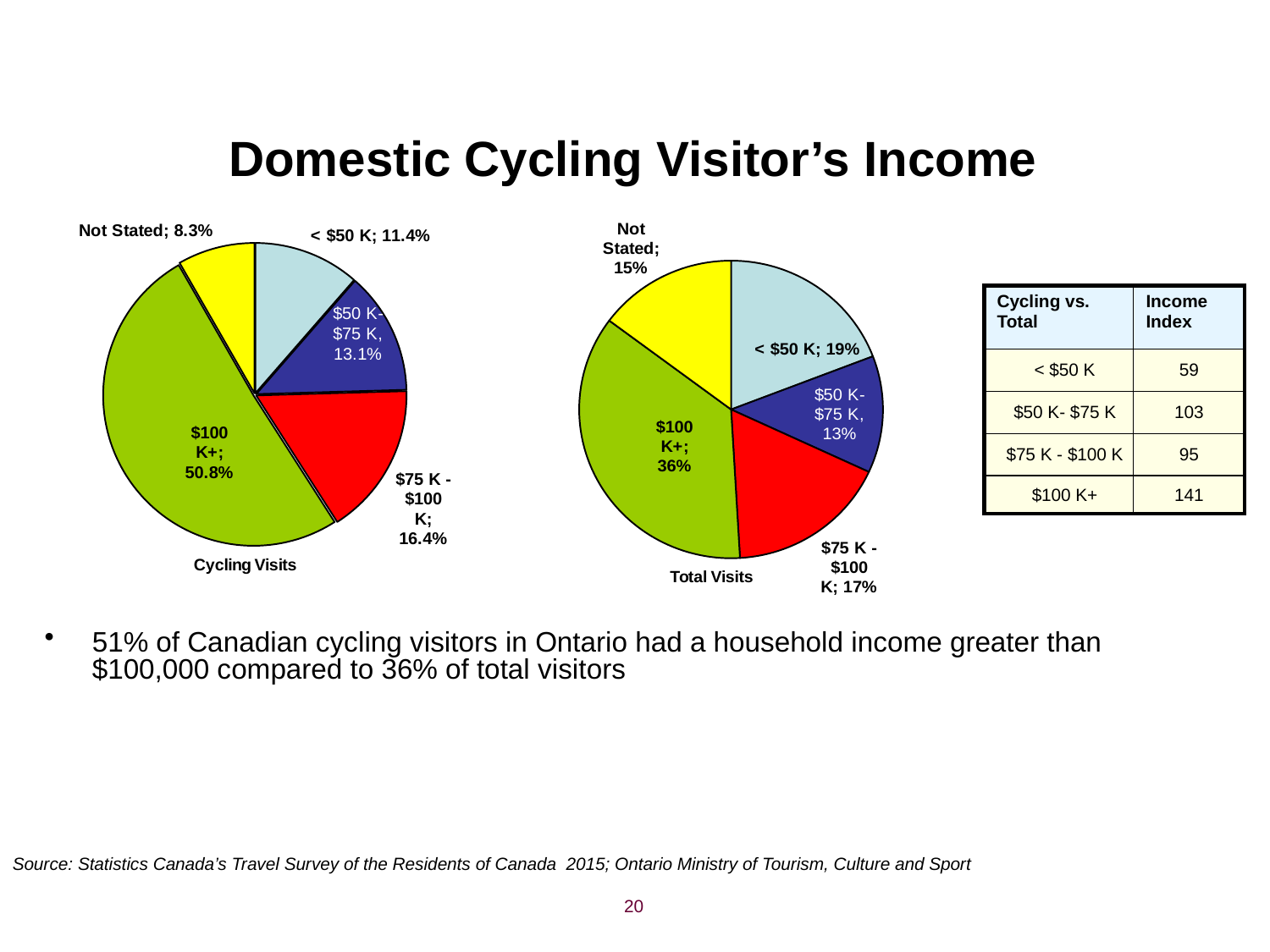
In the Cycling Visits pie chart, which income category has the smallest share? Not Stated In the Cycling Visits pie chart, what share of visitors had a household income of $100 K+? 50.8% How many slices does the Cycling Visits pie chart have? 5 In the Total Visits pie chart, what share of visitors had a household income of $75 K - $100 K? 17% In the Cycling Visits pie chart, what share is labelled Not Stated? 8.3% In the Total Visits pie chart, which income category has the largest share? $100 K+ In the Cycling Visits pie chart, which income category has the largest share? $100 K+ In the Total Visits pie chart, what share of visitors had a household income of < $50 K? 19% What is the difference between the $100 K+ share in the Cycling Visits pie chart and the $100 K+ share in the Total Visits pie chart? 14.8 percentage points In the Cycling Visits pie chart, which is larger: the share for $75 K - $100 K or the share for $50 K - $75 K? $75 K - $100 K What type of chart is used to show Cycling Visits and Total Visits? Pie chart In the Cycling Visits pie chart, what colour is the $100 K+ slice? Green